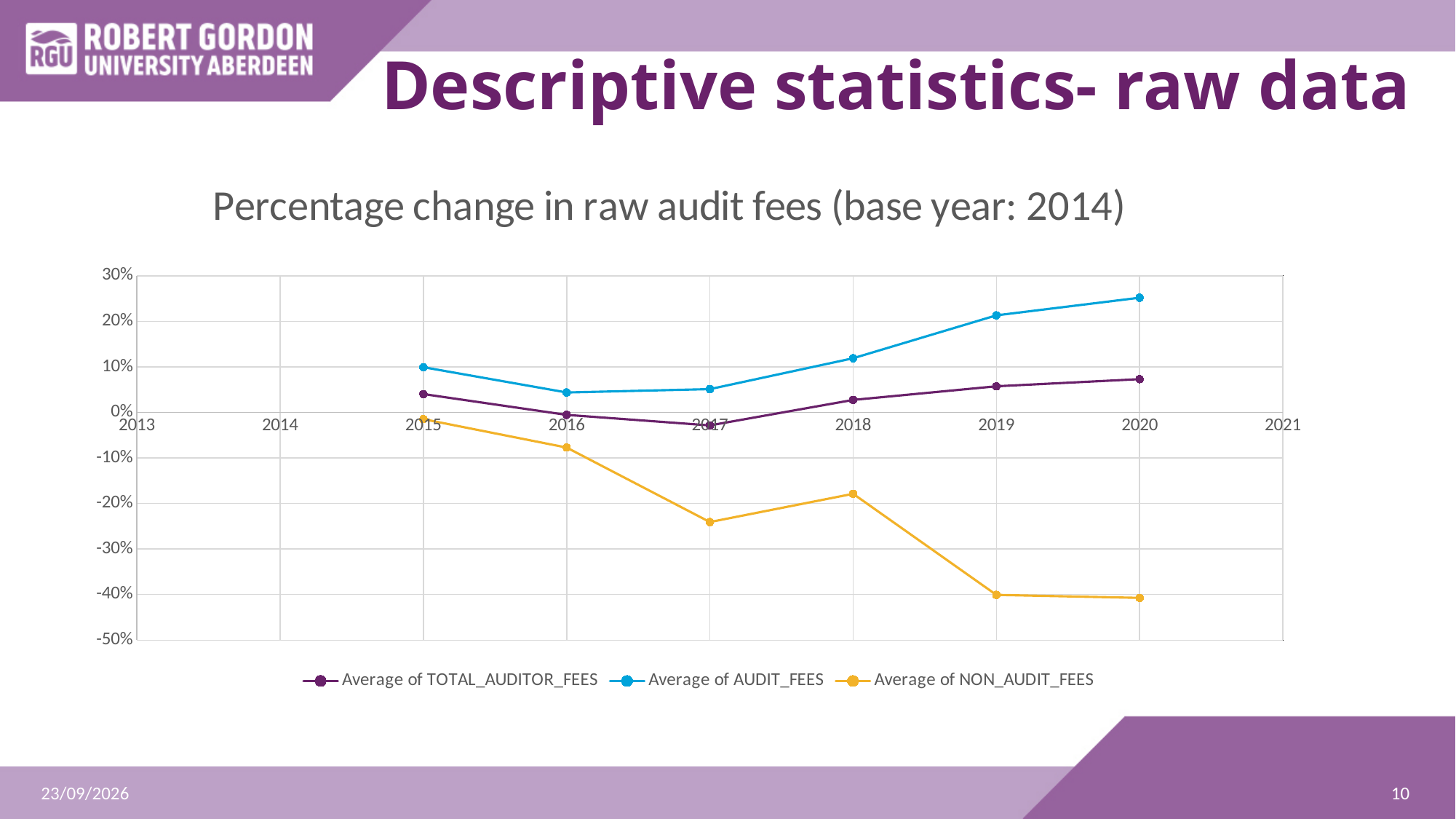
What is the title of the chart? Percentage change in raw audit fees (base year: 2014) How many data points are plotted for the Average of AUDIT_FEES series? 6 Is the value for Average of NON_AUDIT_FEES in 2017 greater or less than -20%? less Is the value for Average of TOTAL_AUDITOR_FEES in 2020 greater or less than 10%? less Is the value for Average of AUDIT_FEES in 2020 greater or less than 20%? greater What kind of chart is shown on the slide? line chart In 2018, which series has the higher value: Average of AUDIT_FEES or Average of TOTAL_AUDITOR_FEES? Average of AUDIT_FEES How many series does the legend list? 3 Does the Average of AUDIT_FEES series rise or fall from 2017 to 2020? rise Which colour is used for the Average of NON_AUDIT_FEES series? yellow In which year is the Average of AUDIT_FEES series at its highest? 2020